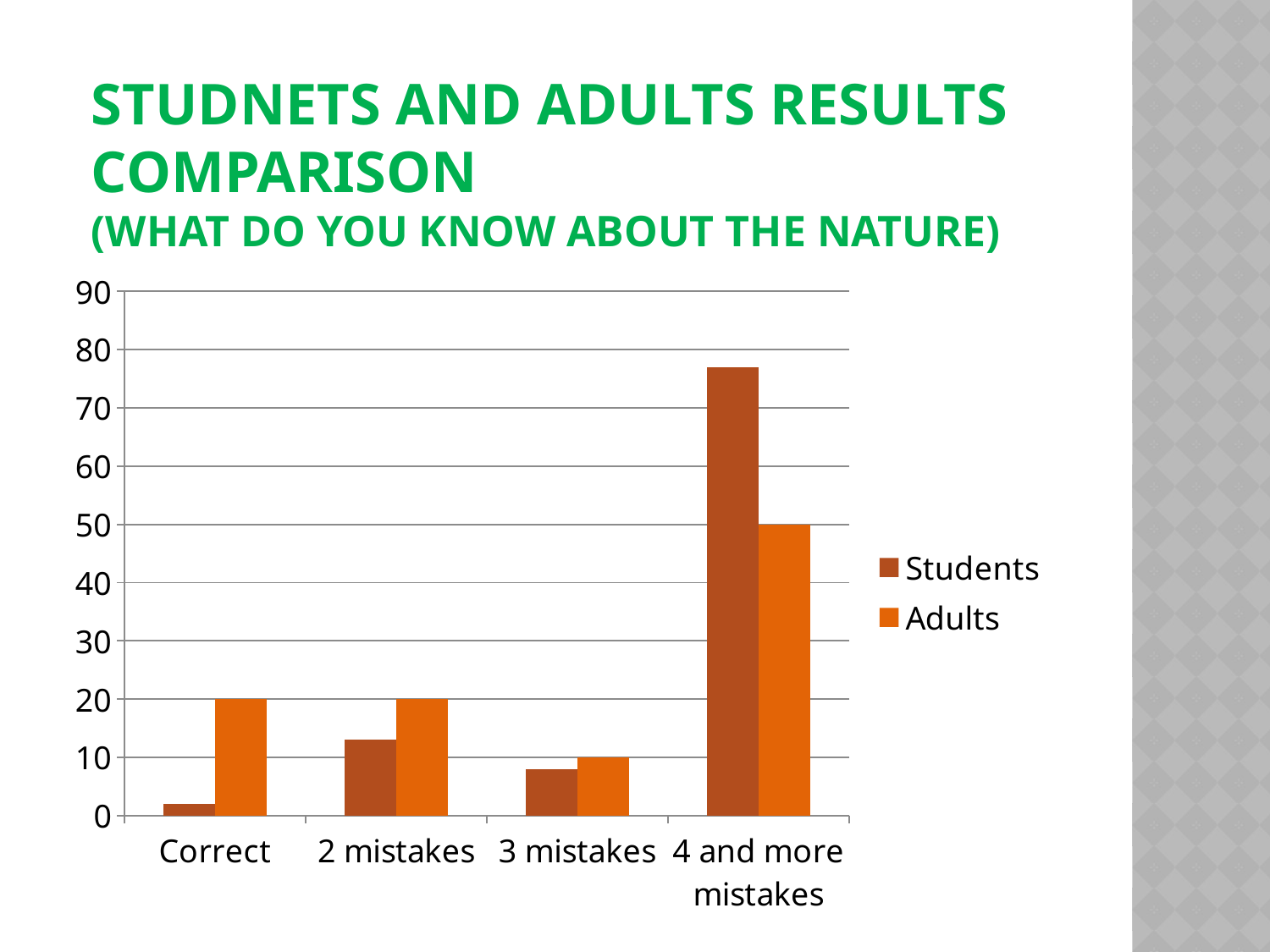
Which category has the lowest value for Adults? 3 mistakes Which category has the lowest value for Students? Correct How many series does the legend list? 2 Is the value for Students in the Correct category greater or less than 10? less How many categories are shown on the x axis? 4 In the Correct category, which is larger, Students or Adults? Adults Is the value for Students in the 4 and more mistakes category greater or less than 70? greater In the 4 and more mistakes category, which is larger, Students or Adults? Students Which category has the highest value for Students? 4 and more mistakes What is the value for Adults in the 4 and more mistakes category? 50 Which category has the highest value for Adults? 4 and more mistakes What kind of chart is shown on the slide? bar chart